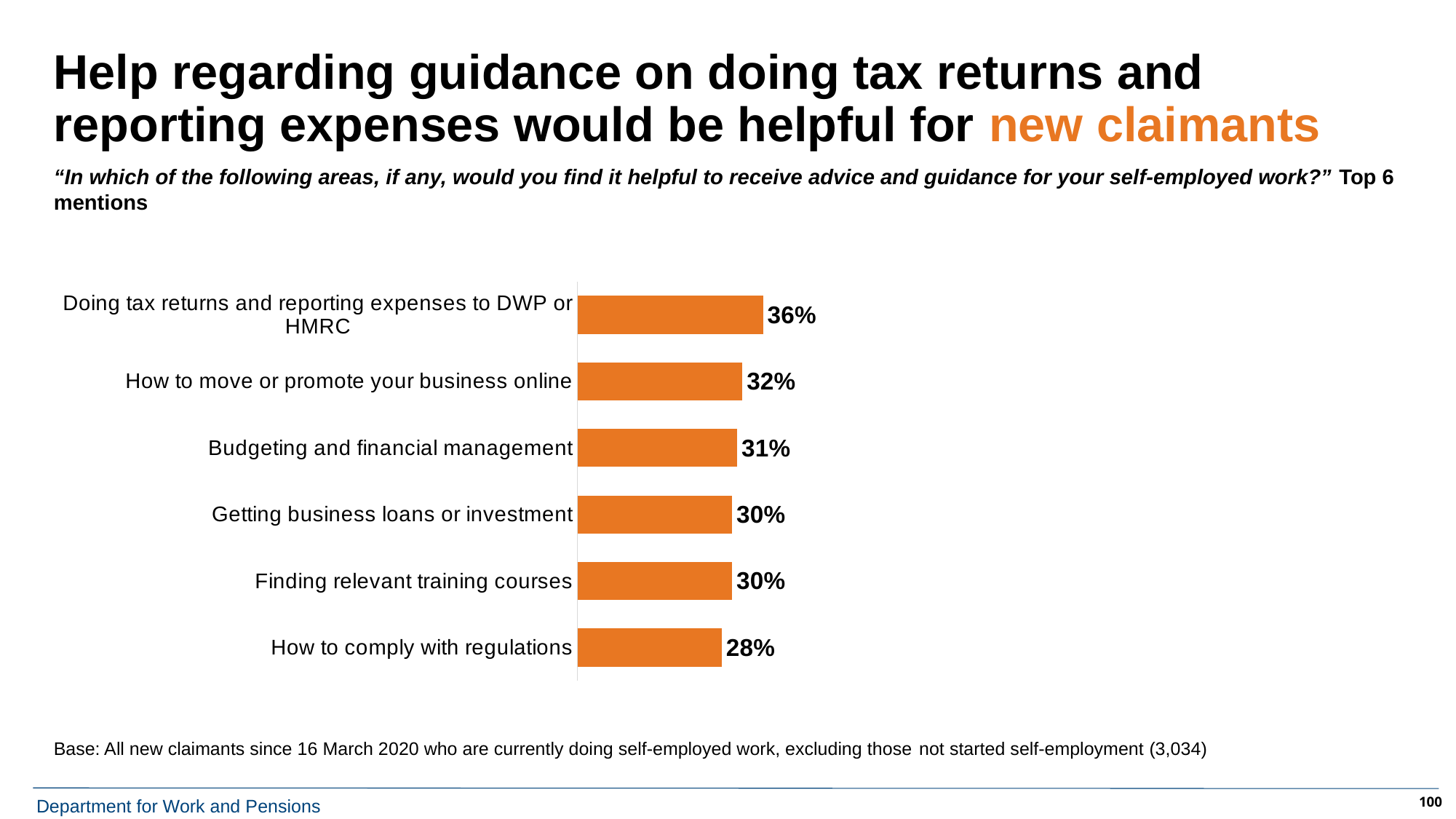
Which has a higher value: 'How to move or promote your business online' or 'Getting business loans or investment'? How to move or promote your business online Which area has the highest percentage of mentions? Doing tax returns and reporting expenses to DWP or HMRC How many areas are shown in the chart? 6 What colour are the bars in the chart? Orange What is the value for 'How to comply with regulations'? 28% What is the value for 'Budgeting and financial management'? 31% What is the value for 'How to move or promote your business online'? 32% What type of chart is shown on the slide? Bar chart What percentage of new claimants said help with doing tax returns and reporting expenses to DWP or HMRC would be helpful? 36% Which two areas share the same value of 30%? Getting business loans or investment; Finding relevant training courses What is the difference in percentage points between 'Doing tax returns and reporting expenses to DWP or HMRC' and 'How to comply with regulations'? 8 percentage points Which area has the lowest percentage of mentions? How to comply with regulations